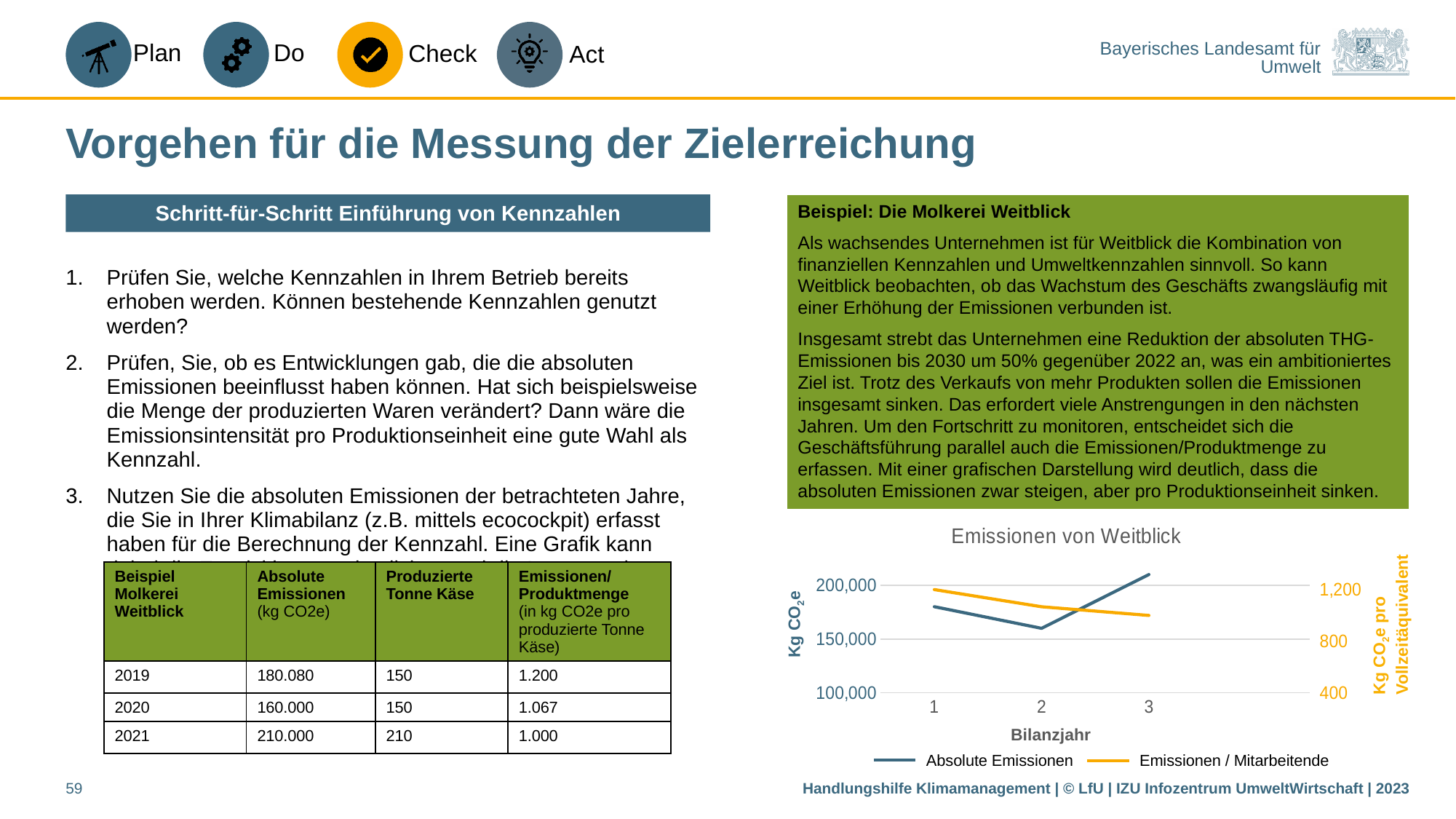
In which Bilanzjahr is the value of Absolute Emissionen lowest? 2 Is the value of Absolute Emissionen in Bilanzjahr 3 greater or less than 200,000? greater Is the value of Emissionen / Mitarbeitende in Bilanzjahr 3 greater or less than 1,200? less What is the label of the x axis of the chart? Bilanzjahr What is the title of the chart on the slide? Emissionen von Weitblick What type of chart is shown on the slide? line chart How many series does the chart's legend list? 2 Which is larger: Absolute Emissionen in Bilanzjahr 1 or in Bilanzjahr 3? Bilanzjahr 3 Is the value of Absolute Emissionen in Bilanzjahr 2 greater or less than 200,000? less In which Bilanzjahr is the value of Absolute Emissionen highest? 3 How many points are plotted along the x axis (Bilanzjahr) for each series? 3 Does the Emissionen / Mitarbeitende series rise or fall from Bilanzjahr 1 to Bilanzjahr 3? fall